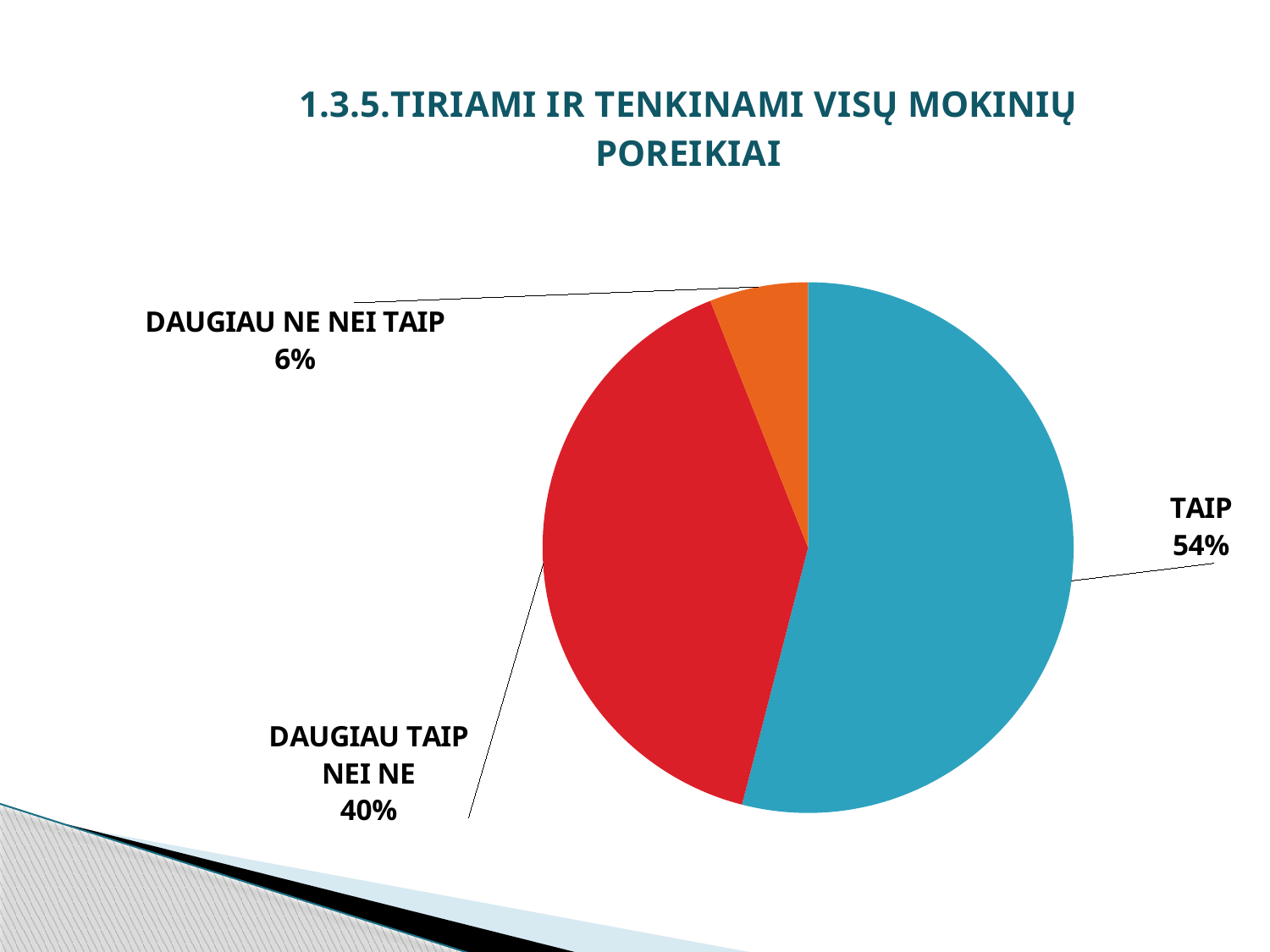
What is the title of the slide? 1.3.5.TIRIAMI IR TENKINAMI VISŲ MOKINIŲ POREIKIAI What is the difference in percentage points between TAIP and DAUGIAU TAIP NEI NE? 14 What is the difference in percentage points between DAUGIAU TAIP NEI NE and DAUGIAU NE NEI TAIP? 34 How many slices does the pie chart have? 3 What percentage is shown for TAIP? 54% What colour is the slice for TAIP? blue What percentage is shown for DAUGIAU NE NEI TAIP? 6% Which is larger, the share for TAIP or the share for DAUGIAU TAIP NEI NE? TAIP Which category has the smallest share of the pie? DAUGIAU NE NEI TAIP What kind of chart is shown on the slide? pie chart What percentage is shown for DAUGIAU TAIP NEI NE? 40% Which category has the largest share of the pie? TAIP